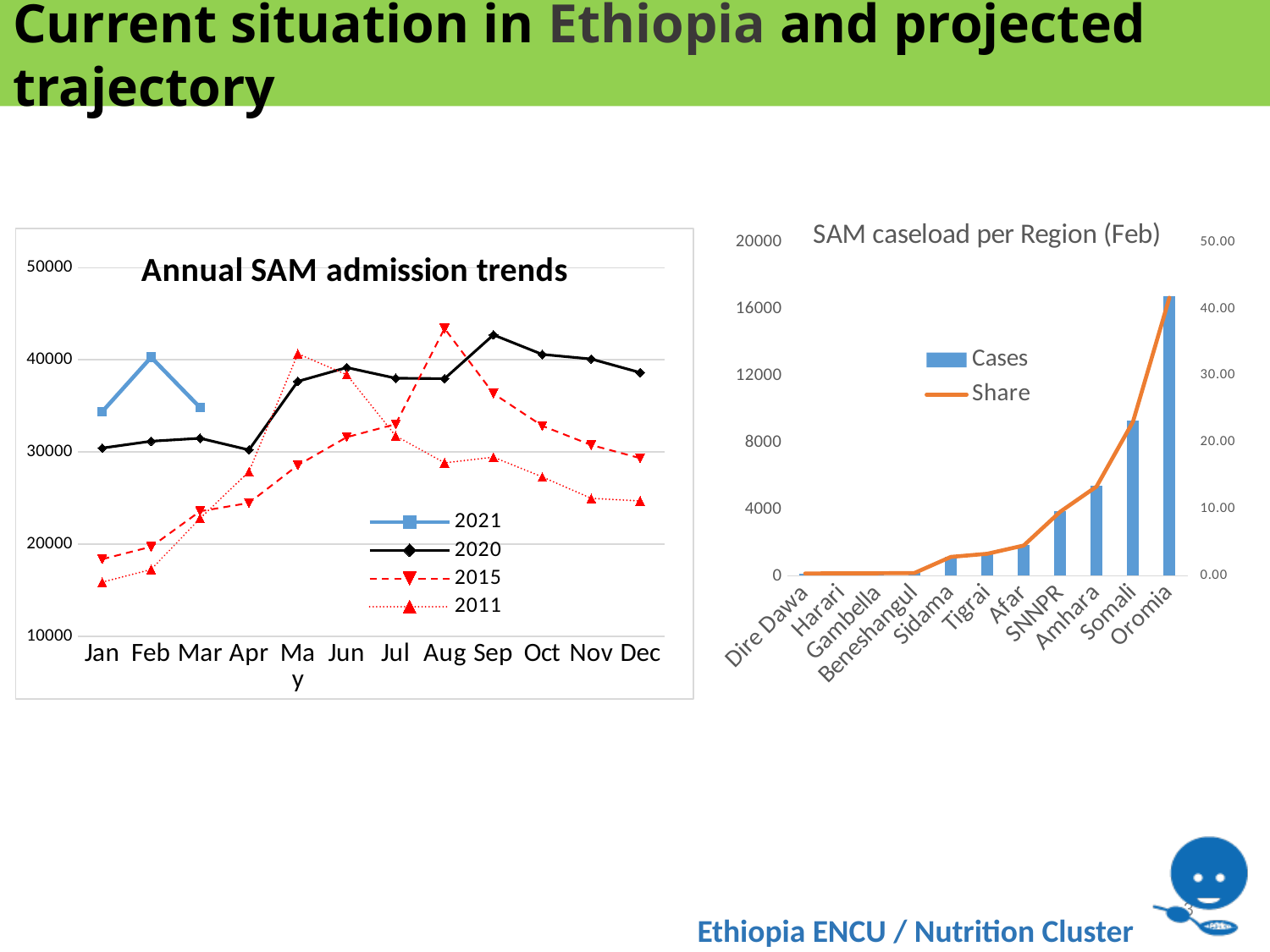
In the 'SAM caseload per Region (Feb)' chart, which region has the highest number of cases? Oromia How many months are shown on the x axis of the 'Annual SAM admission trends' chart? 12 In the 'Annual SAM admission trends' chart, in which month does the 2020 series reach its highest value? Sep In the 'Annual SAM admission trends' chart, which is larger for 2020: the Jan value or the Sep value? Sep What type of chart is the 'Annual SAM admission trends' chart? line chart In the 'Annual SAM admission trends' chart, in which month does the 2015 series reach its highest value? Aug In the 'SAM caseload per Region (Feb)' chart, which region has more cases: Somali or Amhara? Somali In the 'Annual SAM admission trends' chart, is the 2011 value for Jan greater or less than 20000? less In the 'SAM caseload per Region (Feb)' chart, is the Cases value for Somali greater or less than 8000? greater In the 'SAM caseload per Region (Feb)' chart, how many regions are shown on the x axis? 11 In the 'Annual SAM admission trends' chart, is the 2020 value for Sep greater or less than 40000? greater How many series does the legend of the 'Annual SAM admission trends' chart list? 4